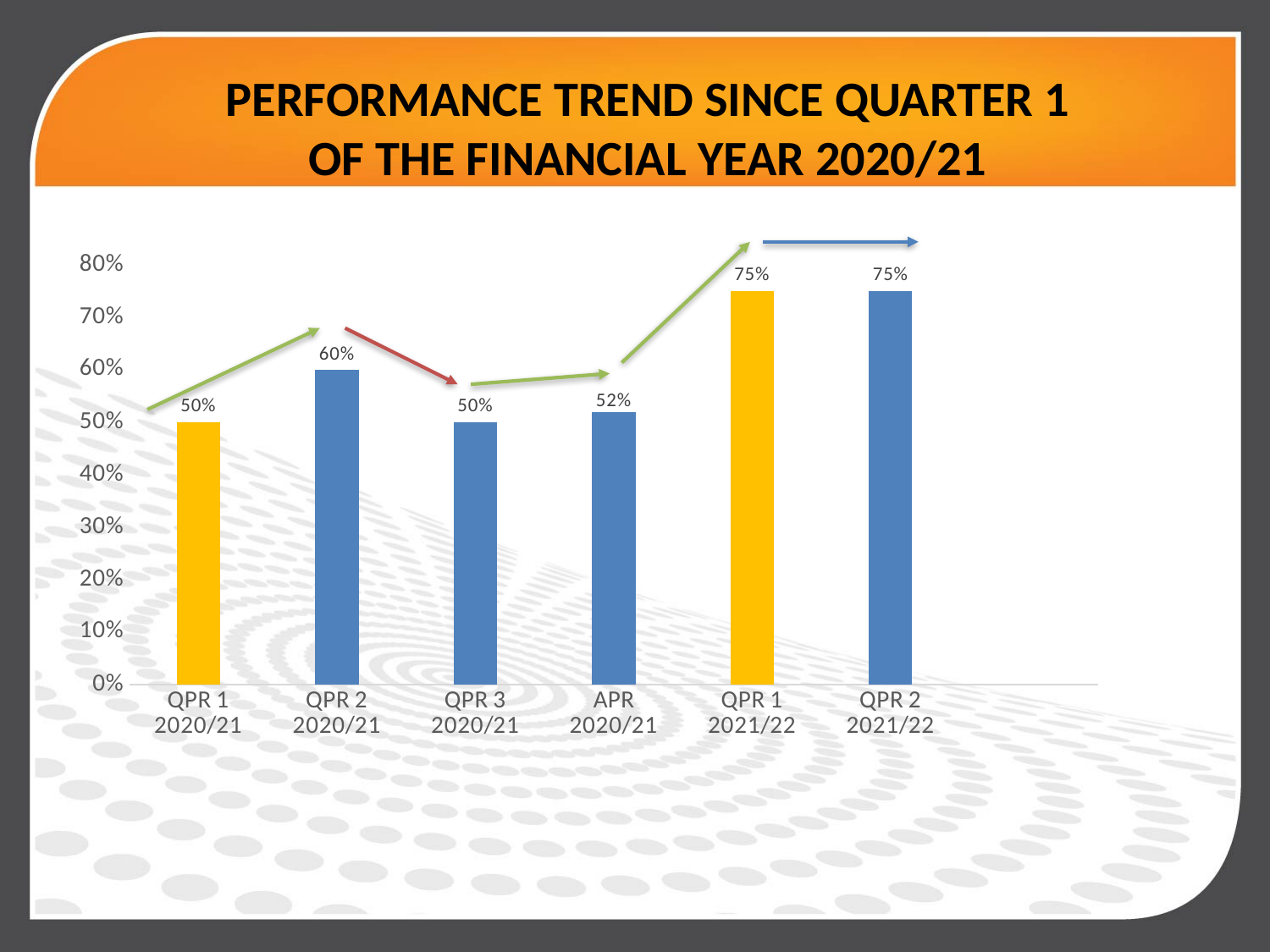
Does the value rise or fall from QPR 2 2020/21 to QPR 3 2020/21? fall Which category has the lowest value, QPR 2 2020/21 or APR 2020/21? APR 2020/21 What is the value for APR 2020/21? 52% What is the title of the slide? PERFORMANCE TREND SINCE QUARTER 1 OF THE FINANCIAL YEAR 2020/21 What is the value for QPR 1 2020/21? 50% What kind of chart is shown on the slide? bar chart How many categories are shown on the x axis? 6 What is the value for QPR 2 2020/21? 60% What is the value for QPR 2 2021/22? 75% Is the value for QPR 2 2020/21 greater or less than 50%? greater What is the difference between the values for APR 2020/21 and QPR 3 2020/21? 2% What is the difference between the values for QPR 1 2021/22 and QPR 2 2020/21? 15%